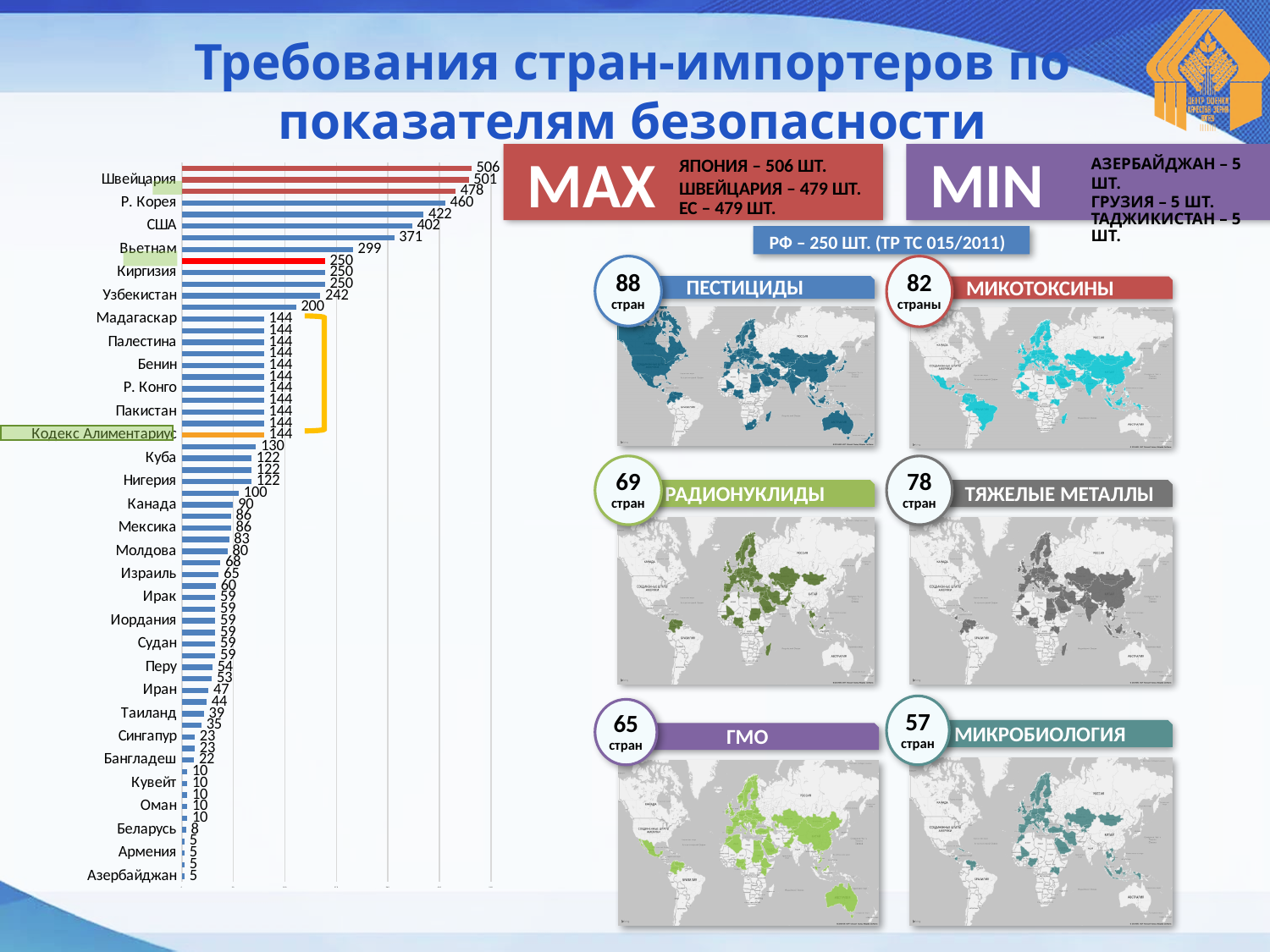
What value is shown for Азербайджан in the bar chart? 5 What is the lowest value printed on the bar chart? 5 What value is shown for Кодекс Алиментариус in the bar chart? 144 What value is shown for Беларусь in the bar chart? 8 Do the bar values increase or decrease going from the top of the chart to the bottom? Decrease What value is shown for США in the bar chart? 402 What is the difference between the values for США and Вьетнам? 103 Which has a larger value, Р. Корея or США? Р. Корея What is the highest value printed on the bar chart? 506 What value is shown for Канада in the bar chart? 90 What kind of chart is shown on the left of the slide? Bar chart What value is shown for Вьетнам in the bar chart? 299